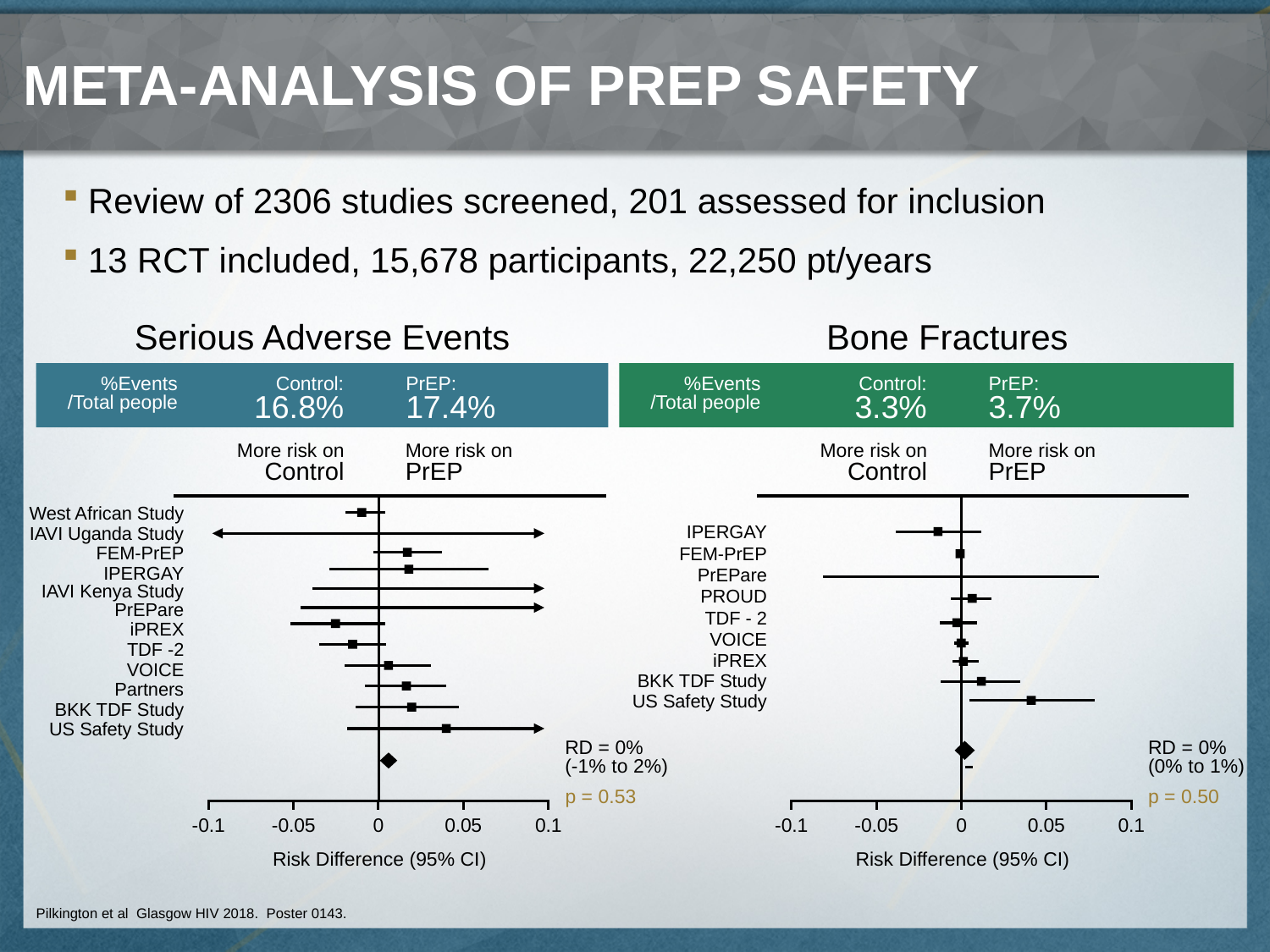
In the Serious Adverse Events chart, what is the percentage of events for the PrEP group? 17.4% In the Serious Adverse Events chart, is the risk difference point estimate for the US Safety Study greater or less than 0? greater In the Serious Adverse Events chart, what is the percentage of events for the Control group? 16.8% In the Bone Fractures chart, what is the pooled risk difference and its 95% confidence interval? RD = 0% (0% to 1%) How many studies are listed in the Serious Adverse Events chart? 12 In the Serious Adverse Events chart, which group has the higher percentage of events, Control or PrEP? PrEP How many studies are listed in the Bone Fractures chart? 9 In the Serious Adverse Events chart, what is the p-value shown for the pooled risk difference? p = 0.53 In the Bone Fractures chart, what is the percentage of events for the Control group? 3.3% In the Bone Fractures chart, what is the percentage of events for the PrEP group? 3.7% In the Bone Fractures chart, what is the difference in percentage points between the PrEP and Control event rates? 0.4 percentage points What is the x-axis label of the Bone Fractures chart? Risk Difference (95% CI)